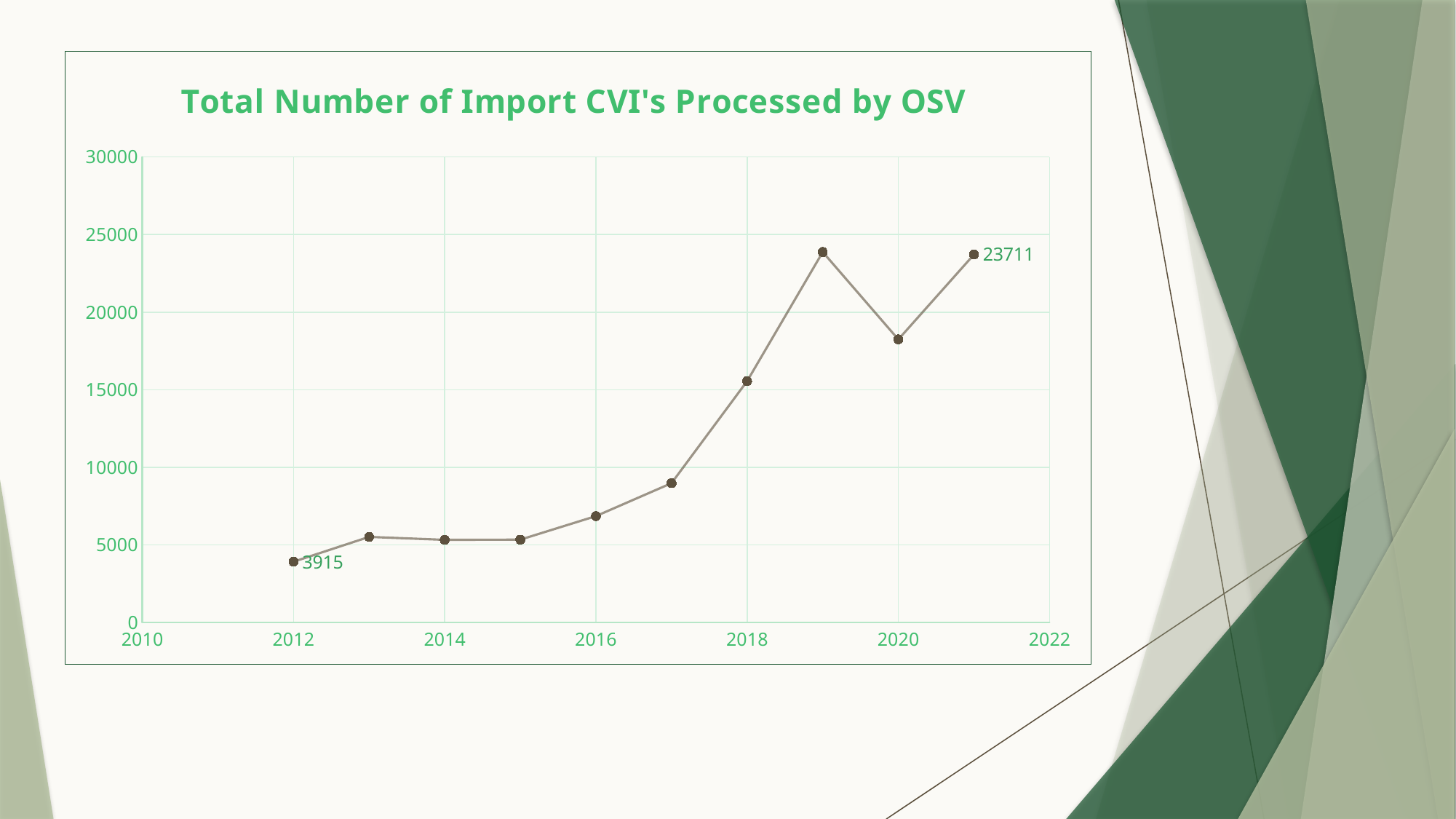
Is the value for 2020 greater or less than 20000? less What is the value for 2012 in the chart? 3915 What is the title of the chart? Total Number of Import CVI's Processed by OSV Which year has the larger value, 2019 or 2020? 2019 Which year has the larger value, 2017 or 2018? 2018 Is the value for 2016 greater or less than 5000? greater Which year has the lowest value in the chart? 2012 What is the difference between the 2021 value and the 2012 value? 19796 Is the value for 2017 greater or less than 10000? less What is the value for 2021 in the chart? 23711 How many data points are plotted in the chart? 10 What kind of chart is shown on the slide? line chart